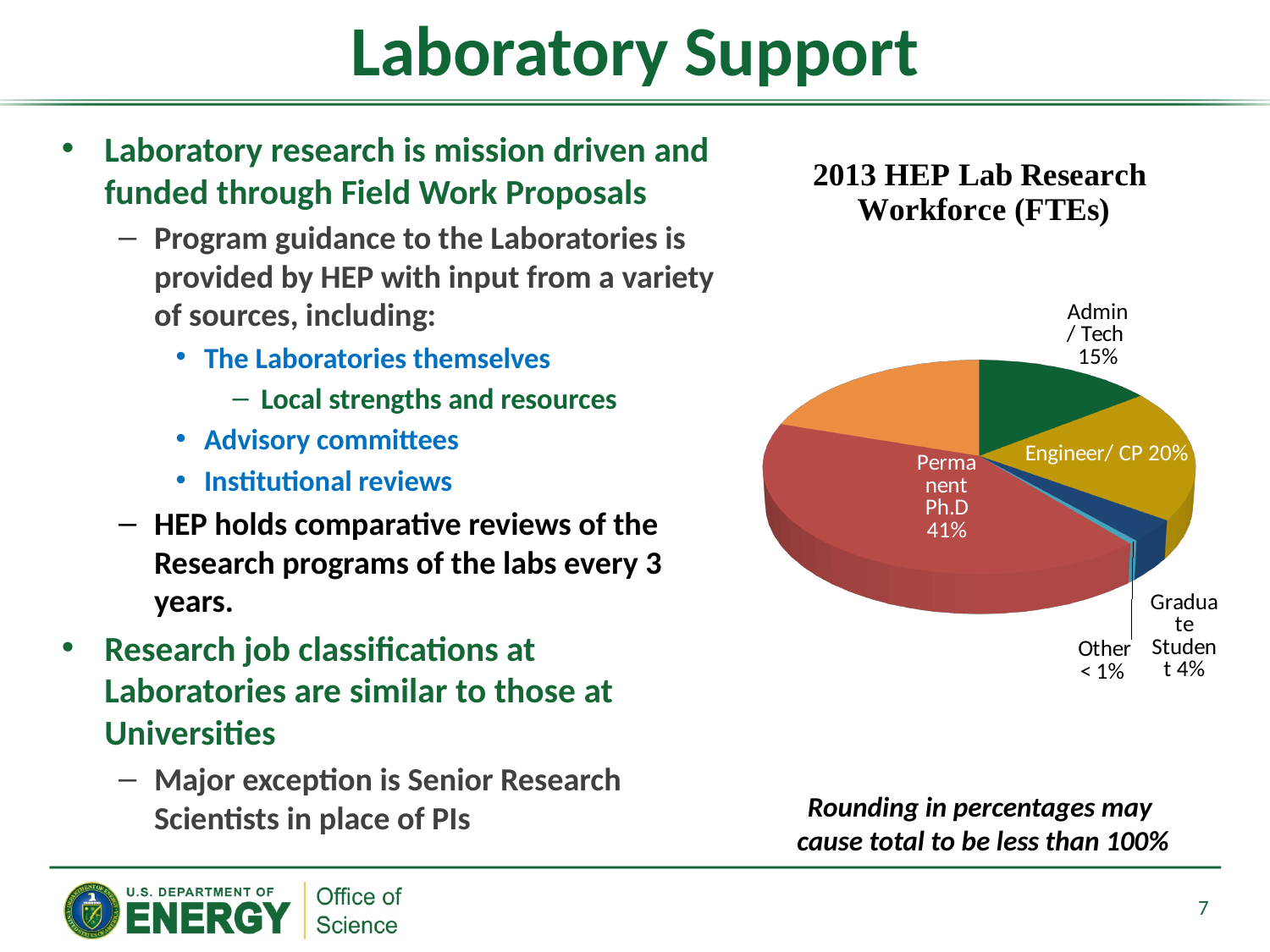
What kind of chart is shown on the slide? Pie chart What percentage of the workforce is Admin/Tech? 15% Which labeled category has the largest share of the pie? Permanent Ph.D Which labeled category has the smallest share of the pie? Other What does the note below the chart say about the percentages? Rounding in percentages may cause total to be less than 100% What is the title of the chart? 2013 HEP Lab Research Workforce (FTEs) What percentage of the 2013 HEP Lab Research Workforce is Permanent Ph.D? 41% Which is larger, the Engineer/CP share or the Admin/Tech share? Engineer/CP How many percentage points larger is the Permanent Ph.D share than the Engineer/CP share? 21 percentage points What percentage is shown for the Other category? < 1% What percentage of the workforce is Graduate Student? 4% What percentage of the workforce is Engineer/CP? 20%